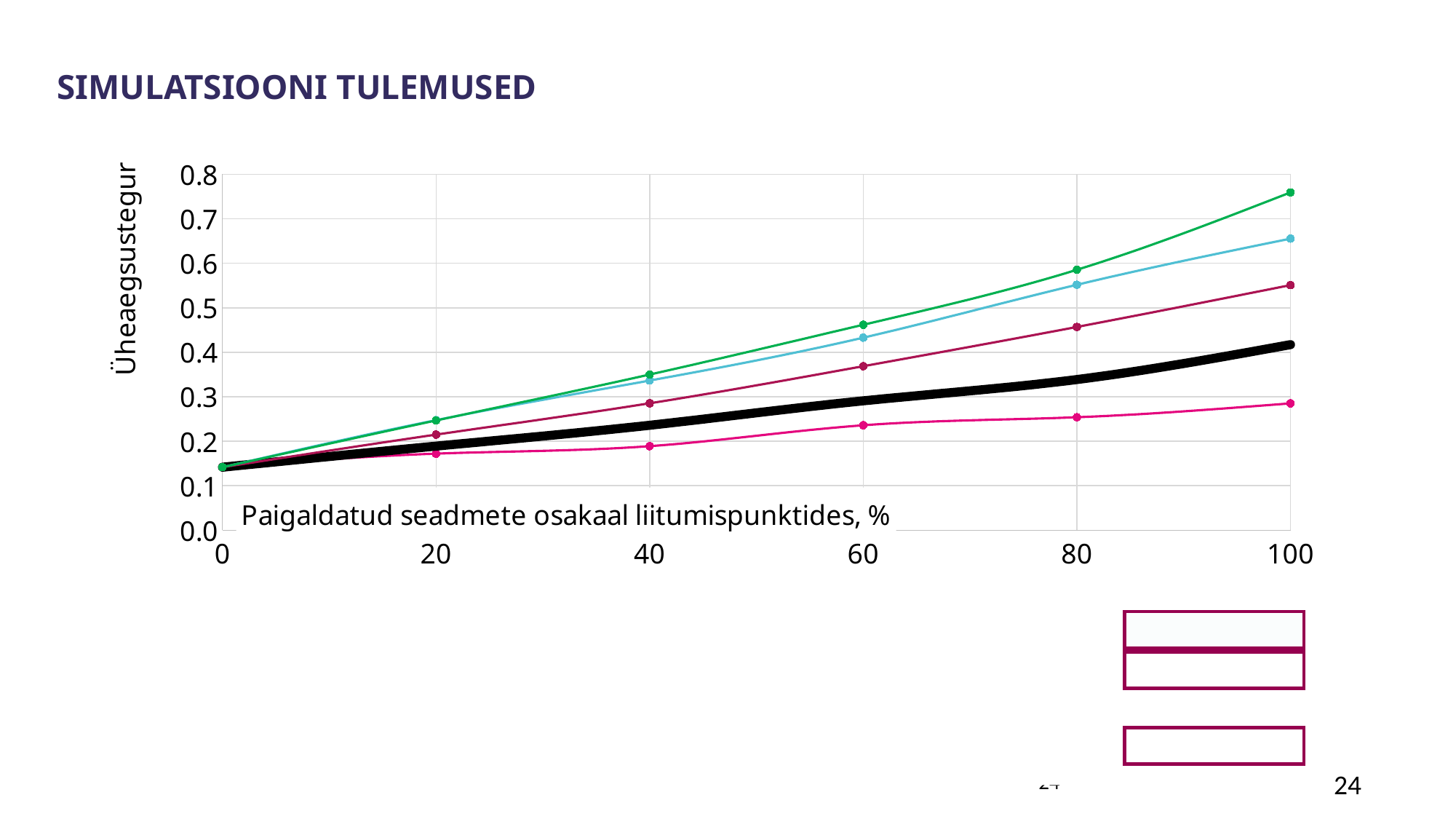
Is the value of the thick black line at x = 100 greater or less than 0.4? greater How many x-axis tick values are shown on the chart? 6 Which line has the lowest value at x = 100? The pink line How many lines are plotted on the chart? 5 Is the value of the pink line at x = 100 greater or less than 0.3? less What is the title of the x-axis? Paigaldatud seadmete osakaal liitumispunktides, % Which line has the highest value at x = 100? The green line Is the value of the green line at x = 100 greater or less than 0.7? greater What is the title of the y-axis? Üheaegsustegur Do the plotted values rise or fall as the x-axis value increases from 0 to 100? Rise What kind of chart is shown on the slide? Line chart At x = 100, which is larger: the green line or the light blue line? The green line